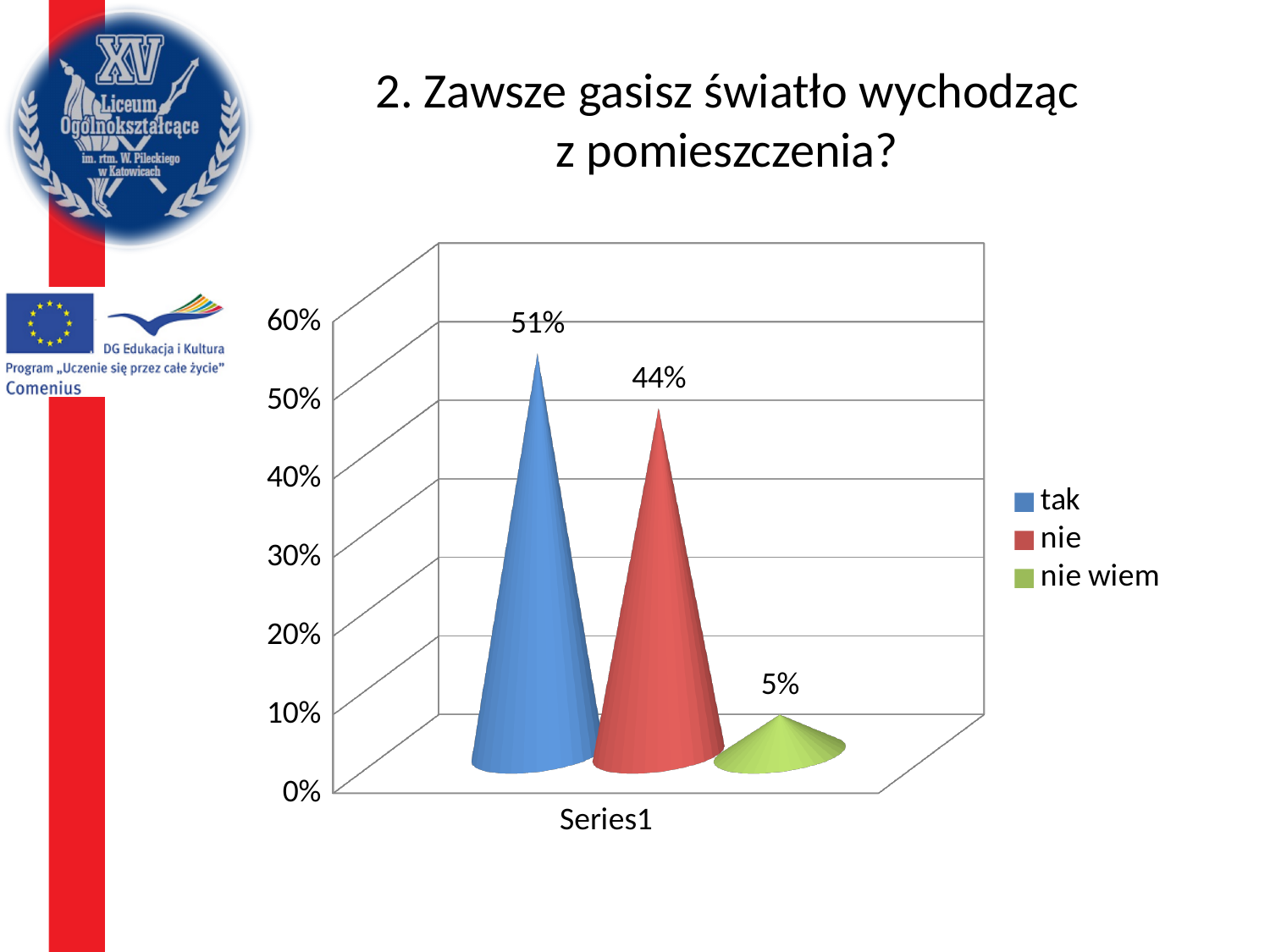
Which is larger, the value for "tak" or the value for "nie wiem"? tak What is the value for "nie"? 44% Which answer has the highest value? tak How many series does the legend list? 3 What colour represents "nie" in the legend? red What is the difference between the values for "nie" and "nie wiem"? 39% What is the value for "nie wiem"? 5% What is the value for "tak"? 51% Which answer has the lowest value? nie wiem What is the difference between the values for "tak" and "nie"? 7% What kind of chart is shown on the slide? bar chart Is the value for "nie" greater or less than 40%? greater